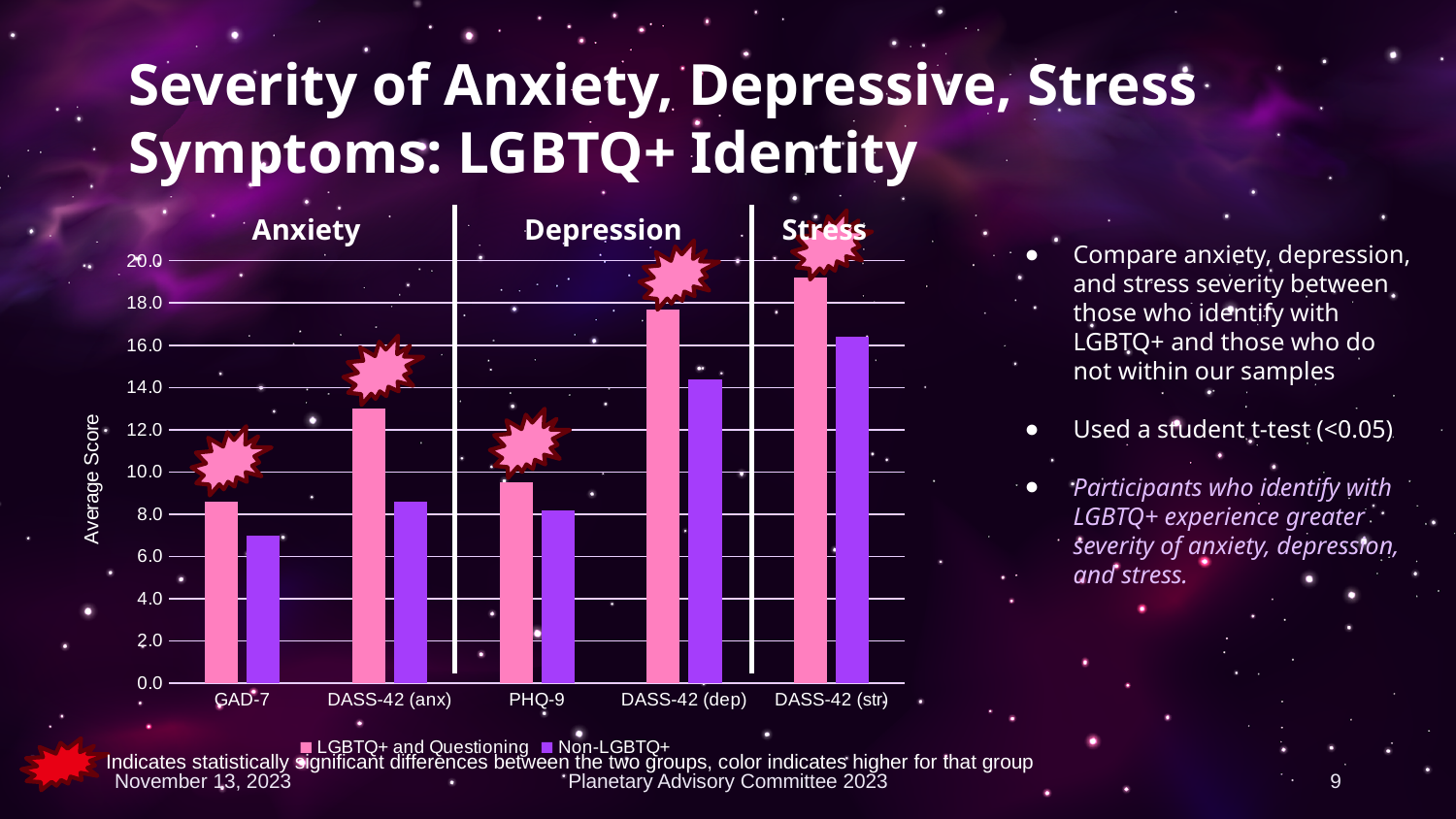
What kind of chart is shown on the slide? bar chart Is the LGBTQ+ and Questioning value for DASS-42 (anx) greater or less than 12.0? greater For which category is the LGBTQ+ and Questioning bar the highest? DASS-42 (str) Which series is shown in pink in the chart? LGBTQ+ and Questioning How many series does the chart legend list? 2 What is the label of the vertical axis of the chart? Average Score Is the LGBTQ+ and Questioning value for DASS-42 (str) greater or less than 20.0? less How many categories are shown on the x axis of the chart? 5 For GAD-7, which group has the larger average score, LGBTQ+ and Questioning or Non-LGBTQ+? LGBTQ+ and Questioning For which category is the Non-LGBTQ+ bar the highest? DASS-42 (str) Is the Non-LGBTQ+ value for GAD-7 greater or less than 8.0? less For which category is the Non-LGBTQ+ bar the lowest? GAD-7